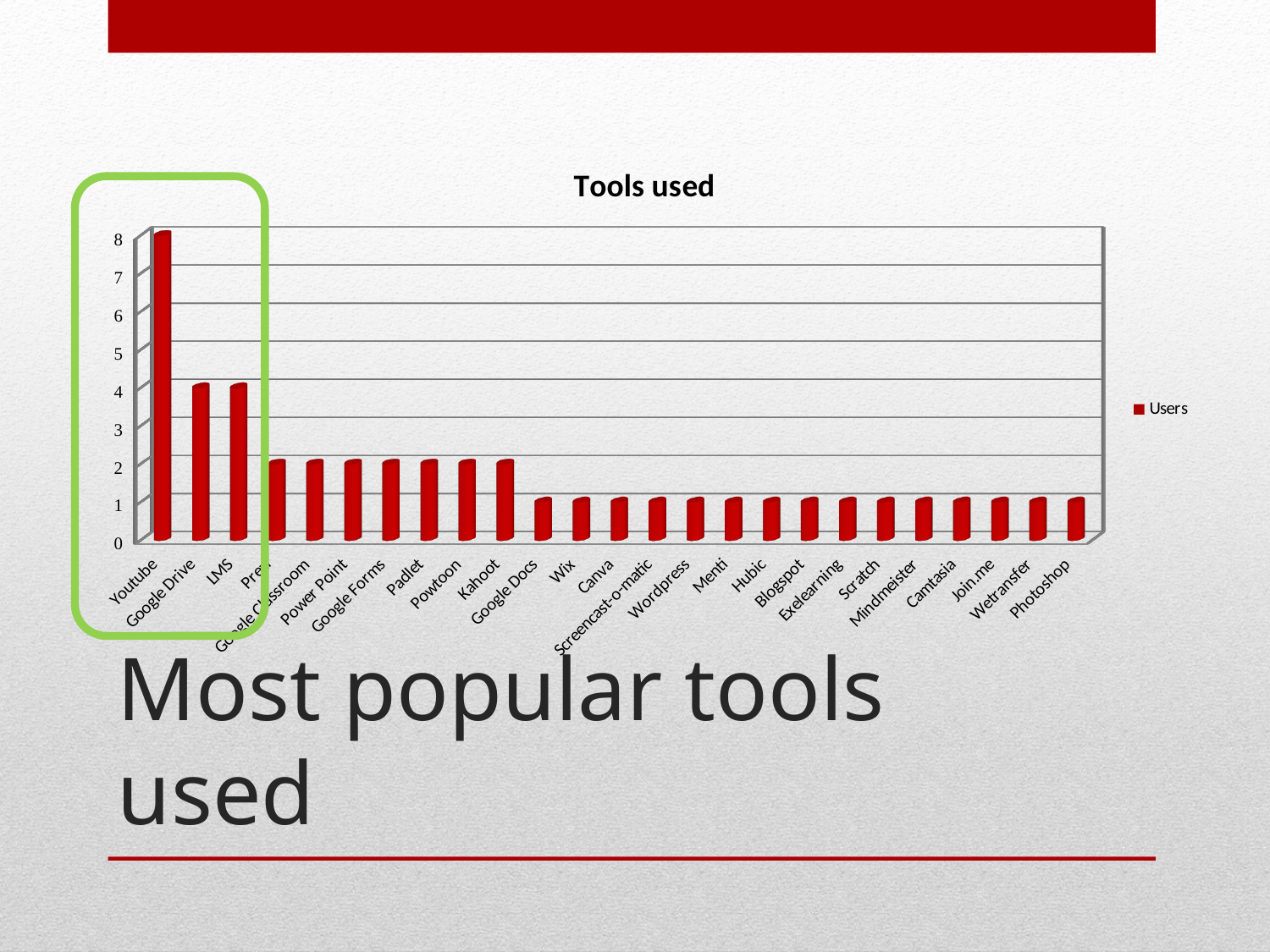
Is the value for Youtube greater or less than 5? greater What is the difference in users between Youtube and Google Drive? 4 Which tool has the highest number of users? Youtube How many users does Google Drive have? 4 What is the title of the chart? Tools used Which has more users, Padlet or Wix? Padlet What kind of chart is shown on the slide? bar chart How many users does Kahoot have? 2 How many users does Photoshop have? 1 How many users does Youtube have? 8 How many series does the legend list? 1 How many tools are shown on the x axis? 25